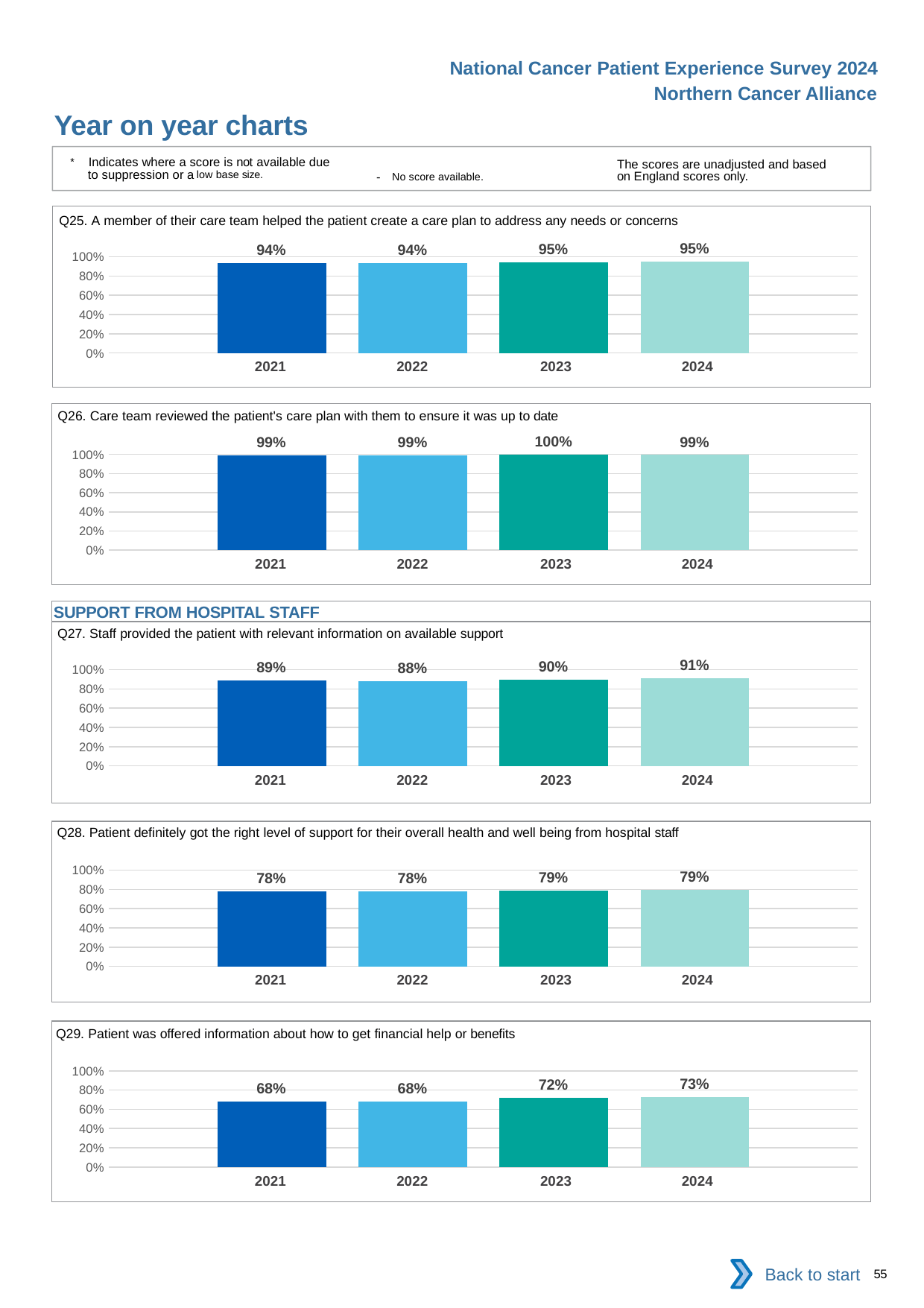
How many charts are shown on the slide? 5 In the Q27 chart, which year has the lowest value? 2022 In the Q28 chart, is the value for 2021 greater or less than 60%? greater In the Q26 chart, which year has the highest value? 2023 What kind of chart is the Q29 chart? bar chart In the Q29 chart, what is the difference between the 2024 value and the 2021 value? 5% In the Q27 chart, what is the value for 2022? 88% In the Q28 chart, what is the value for 2023? 79% In the Q29 chart, do the values generally rise or fall from 2021 to 2024? rise How many years are shown in the Q28 chart? 4 In the Q29 chart, which is larger, the value for 2022 or the value for 2023? 2023 In the Q25 chart, what is the value for 2024? 95%